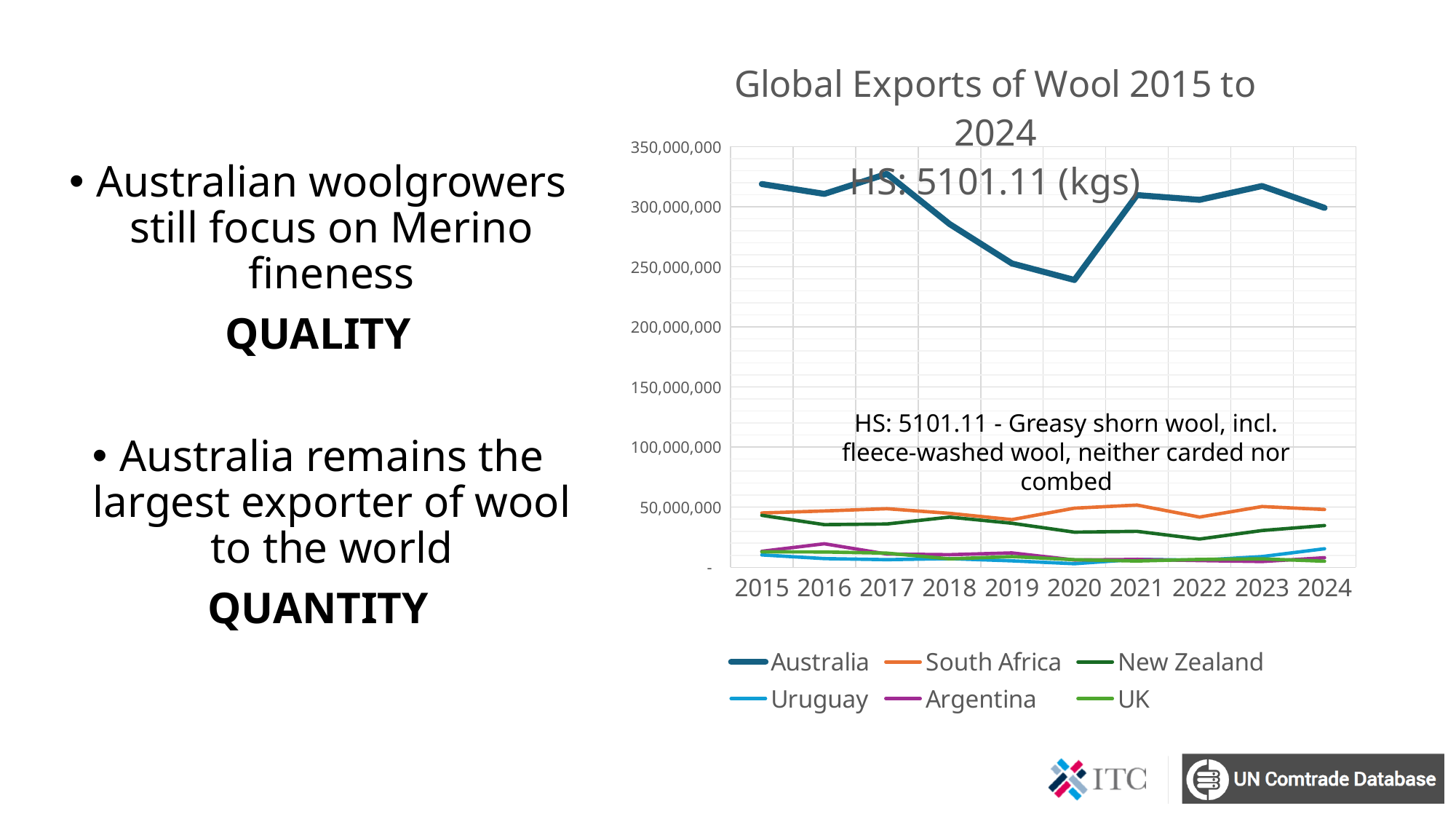
In which year were Australia's wool exports highest? 2017 Is the value for Australia in 2017 greater or less than 300,000,000? greater How many years are plotted along the x axis of the chart? 10 In which year were Australia's wool exports lowest? 2020 What is the title of the chart? Global Exports of Wool 2015 to 2024 HS: 5101.11 (kgs) Do Australia's wool exports rise or fall from 2017 to 2020? Fall How many series does the legend of the chart list? 6 In 2020, which had larger wool exports, South Africa or New Zealand? South Africa Is the value for Australia in 2020 greater or less than 250,000,000? less Which country has the highest wool exports across the whole period shown? Australia What kind of chart is shown on the slide? Line chart Is the value for New Zealand in 2022 greater or less than 50,000,000? less